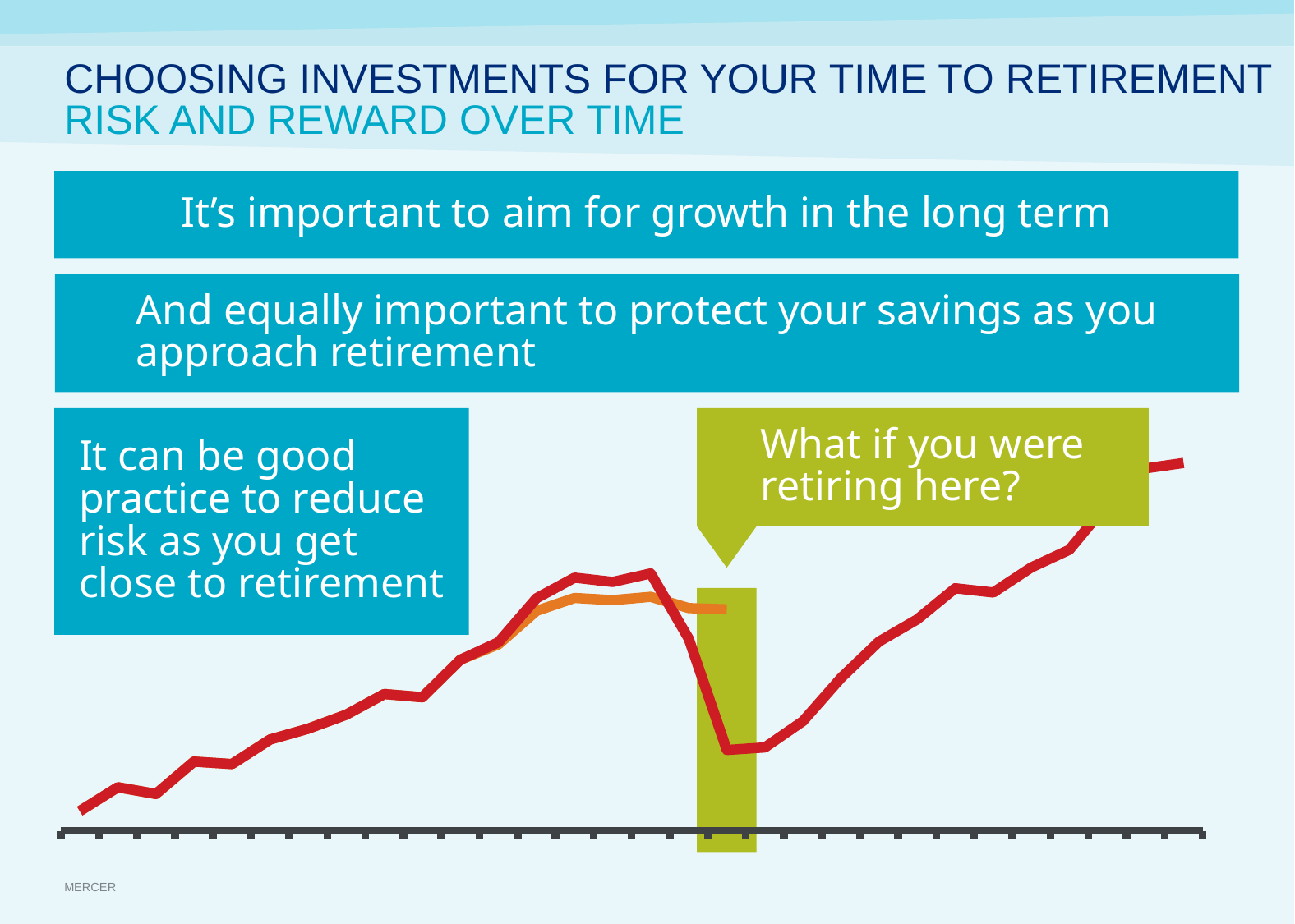
Where the orange line ends, is the red line above or below the orange line? below What kind of chart is shown on the slide? line chart Within the green highlighted band, does the red line rise or fall? fall After the green highlighted band, does the red line rise or fall towards the right edge of the chart? rise Is the red line's value at the right end of the chart higher or lower than its value at the left end? higher What does the green callout above the highlighted band say? What if you were retiring here? Overall, does the red line rise or fall from the left of the chart to the right? rise What colour is the shorter line that branches off the main line before the dip? orange